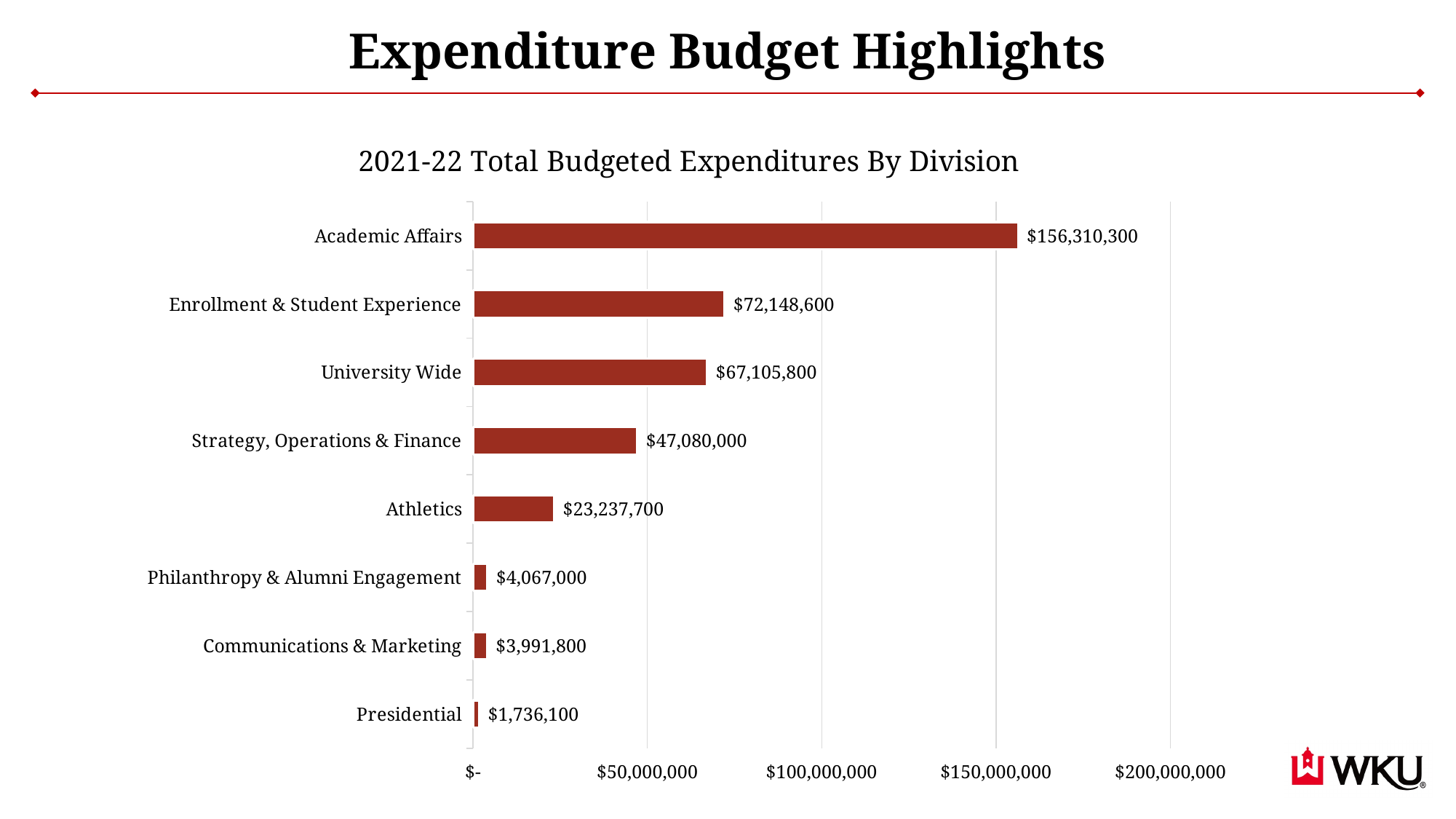
How many divisions are shown in the chart? 8 What is the title of the chart? 2021-22 Total Budgeted Expenditures By Division What is the difference between the budgeted expenditures for Enrollment & Student Experience and University Wide? $5,042,800 What is the budgeted expenditure for Athletics? $23,237,700 What kind of chart is shown on the slide? Bar chart Is the value for Academic Affairs greater or less than $150,000,000? greater Which division has the lowest budgeted expenditure? Presidential What is the budgeted expenditure for Presidential? $1,736,100 What is the budgeted expenditure for Academic Affairs? $156,310,300 What is the difference between the budgeted expenditures for Philanthropy & Alumni Engagement and Communications & Marketing? $75,200 Which has a larger budgeted expenditure, Strategy, Operations & Finance or Athletics? Strategy, Operations & Finance Which division has the highest budgeted expenditure? Academic Affairs